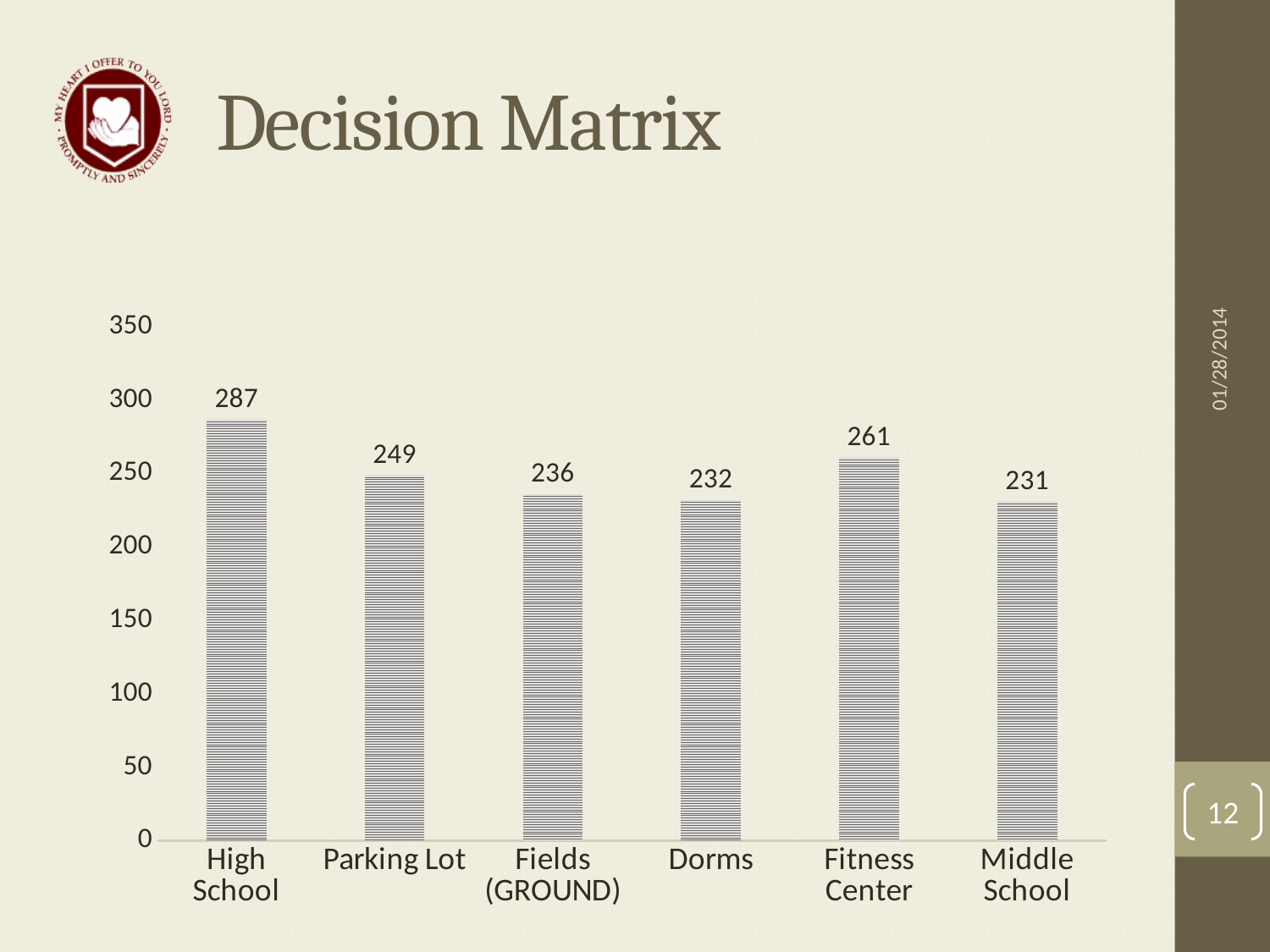
How many categories are shown on the x axis? 6 What is the value for High School? 287 Which is larger, the value for Parking Lot or the value for Fields (GROUND)? Parking Lot Which category has the lowest value? Middle School Is the value for Fitness Center greater or less than 250? greater What is the difference between the values for High School and Parking Lot? 38 What is the value for Dorms? 232 What kind of chart is shown on the slide? bar chart What is the value for Fitness Center? 261 What is the difference between the values for Fitness Center and Middle School? 30 What is the title of the slide containing the chart? Decision Matrix Which category has the highest value? High School